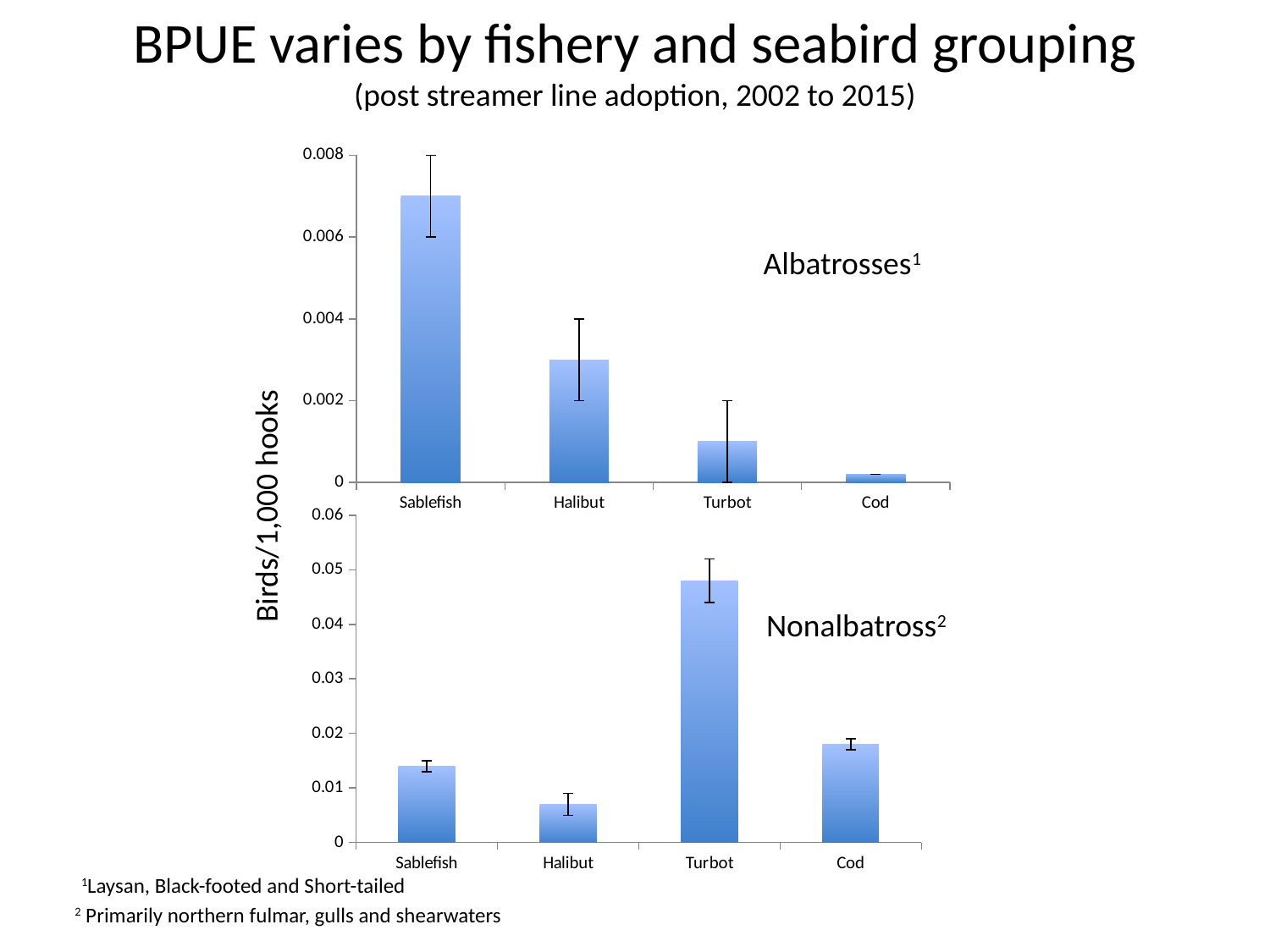
How many fisheries are shown on the x axis of the Albatrosses chart? 4 In the Nonalbatross chart, which fishery has the highest value? Turbot In the Nonalbatross chart, which fishery has the lowest value? Halibut In the Albatrosses chart, is the value for Sablefish greater or less than 0.006? greater In the Nonalbatross chart, is the value for Turbot greater or less than 0.04? greater What is the label on the shared y axis of the two charts? Birds/1,000 hooks In the Albatrosses chart, which fishery has the highest value? Sablefish In the Albatrosses chart, is the value for Halibut greater or less than 0.004? less In the Nonalbatross chart, which is larger, the value for Sablefish or the value for Halibut? Sablefish In the Albatrosses chart, which fishery has the lowest value? Cod What kind of chart is the Nonalbatross chart? Bar chart